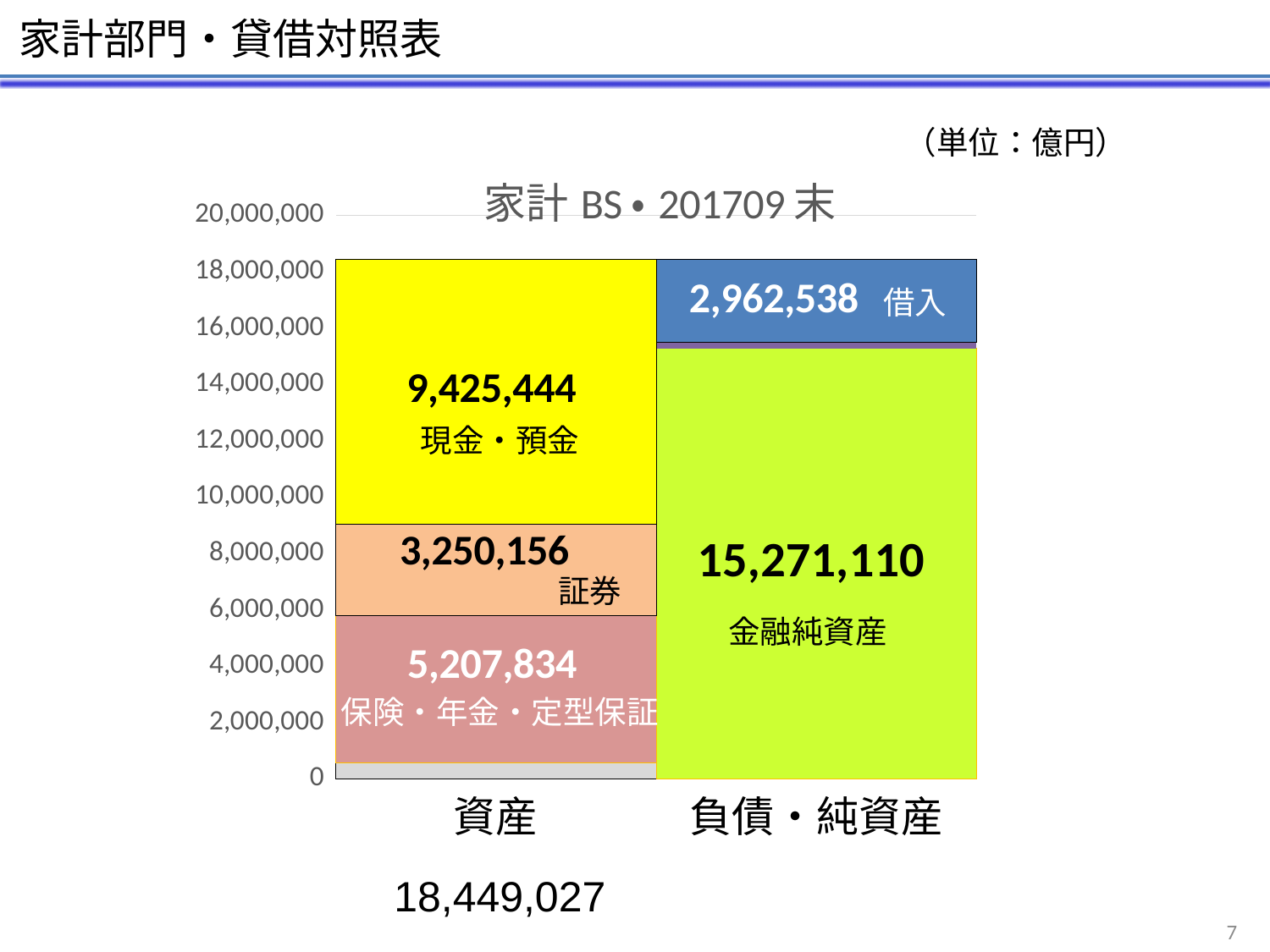
What is the value of 借入 in the 負債・純資産 bar? 2,962,538 What kind of chart is shown on the slide? stacked bar chart What is the value of 金融純資産 in the 負債・純資産 bar? 15,271,110 What is the difference between 現金・預金 and 証券? 6,175,288 Which labelled segment has the smallest value? 借入 What is the title of the chart? 家計 BS・201709 末 What is the value of 現金・預金 in the 資産 bar? 9,425,444 What is the value of 保険・年金・定型保証 in the 資産 bar? 5,207,834 What is the value of 証券 in the 資産 bar? 3,250,156 Which labelled segment has the largest value? 金融純資産 How many bars are plotted on the x axis? 2 Which is larger, 保険・年金・定型保証 or 証券? 保険・年金・定型保証